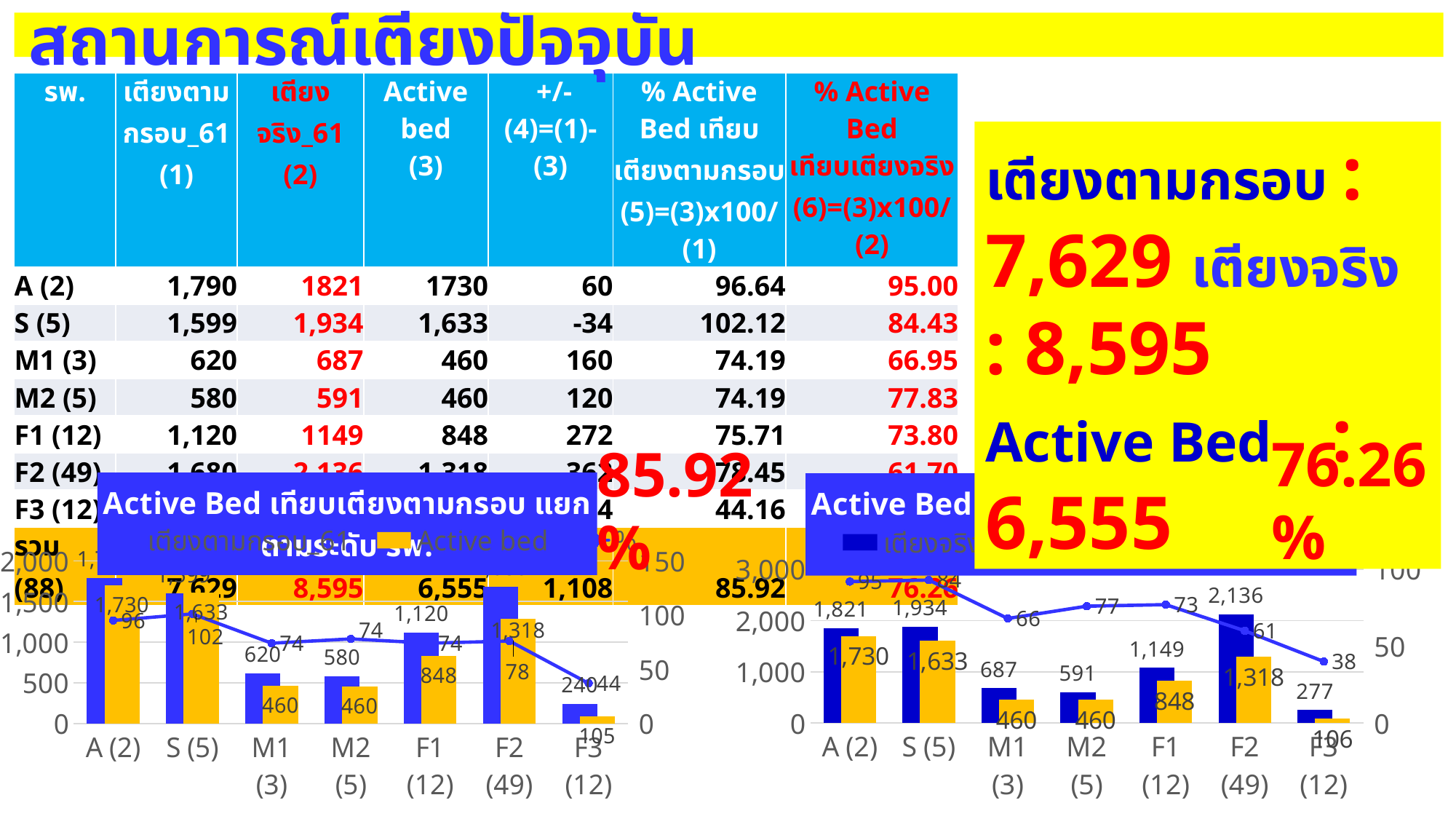
In the right chart, what is the difference between เตียงจริง and Active bed for M1 (3)? 227 In the right chart, what is the Active bed value for M2 (5)? 460 In the left chart, for M1 (3), which is larger: เตียงตามกรอบ_61 or Active bed? เตียงตามกรอบ_61 In the left chart (Active Bed เทียบเตียงตามกรอบ แยกตามระดับ รพ.), what is the Active bed value for F1 (12)? 848 In the left chart, which category has the lowest Active bed bar? F3 (12) In the left chart, is the Active bed value for F2 (49) greater or less than 1,000? greater In the right chart, what is the เตียงจริง value for F2 (49)? 2,136 In the right chart, what is the difference between เตียงจริง and Active bed for S (5)? 301 In the right chart, what is the line value plotted for F3 (12)? 38 What kind of chart is the left chart? bar chart with a line In the right chart, which category has the highest เตียงจริง bar? F2 (49) How many hospital categories are shown on the x axis of the left chart? 7